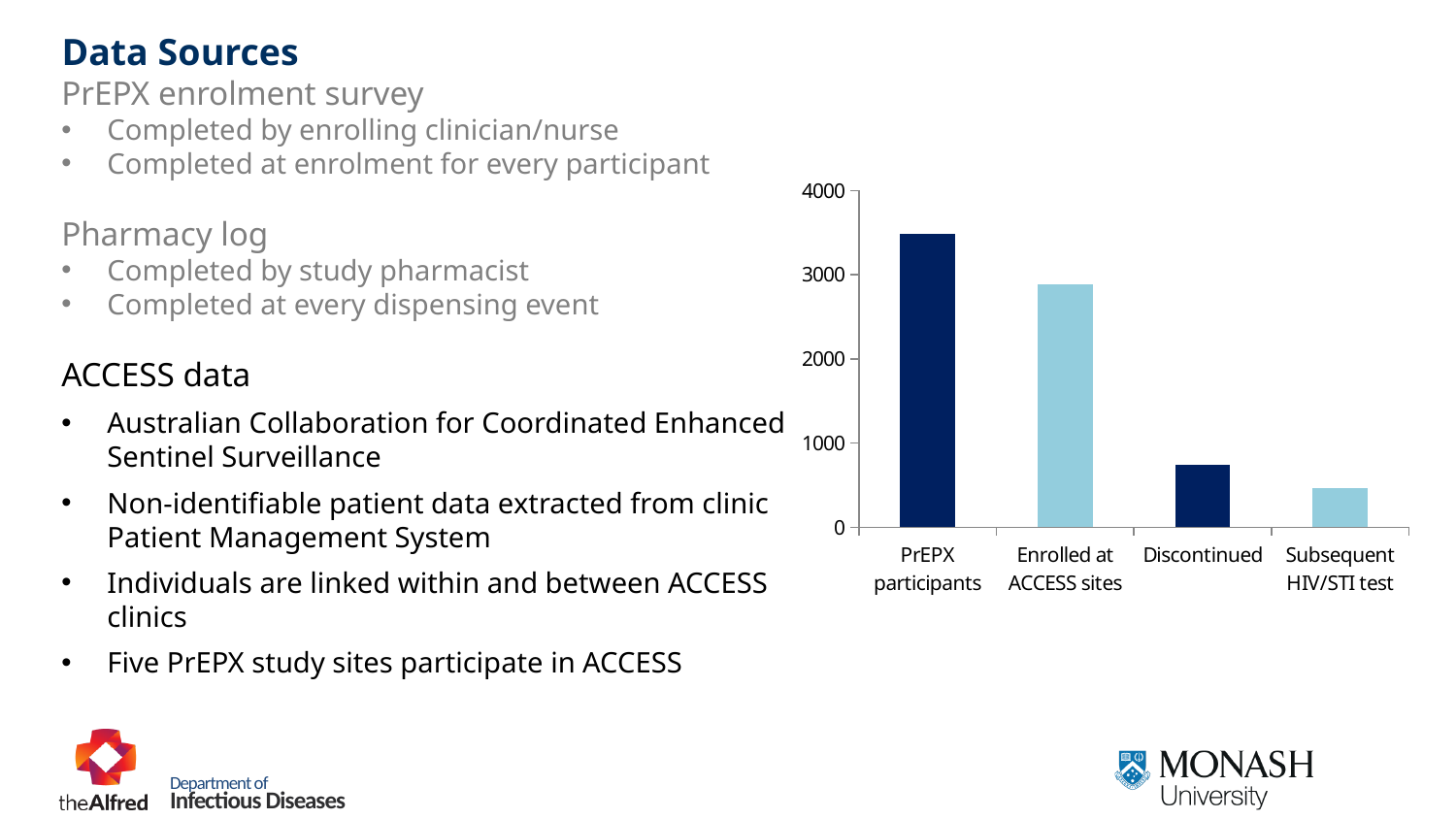
Is the value for Discontinued greater or less than 1000? less What is the highest value shown on the vertical axis of the bar chart? 4000 Is the value for Enrolled at ACCESS sites greater or less than 2000? greater How many categories are shown on the bar chart? 4 Do the bar values rise or fall from left to right across the categories? fall Is the value for Subsequent HIV/STI test greater or less than 1000? less Which category has the highest value in the bar chart? PrEPX participants Which is larger, the value for Discontinued or the value for Subsequent HIV/STI test? Discontinued Which category has the lowest value in the bar chart? Subsequent HIV/STI test What kind of chart is shown on the slide? bar chart